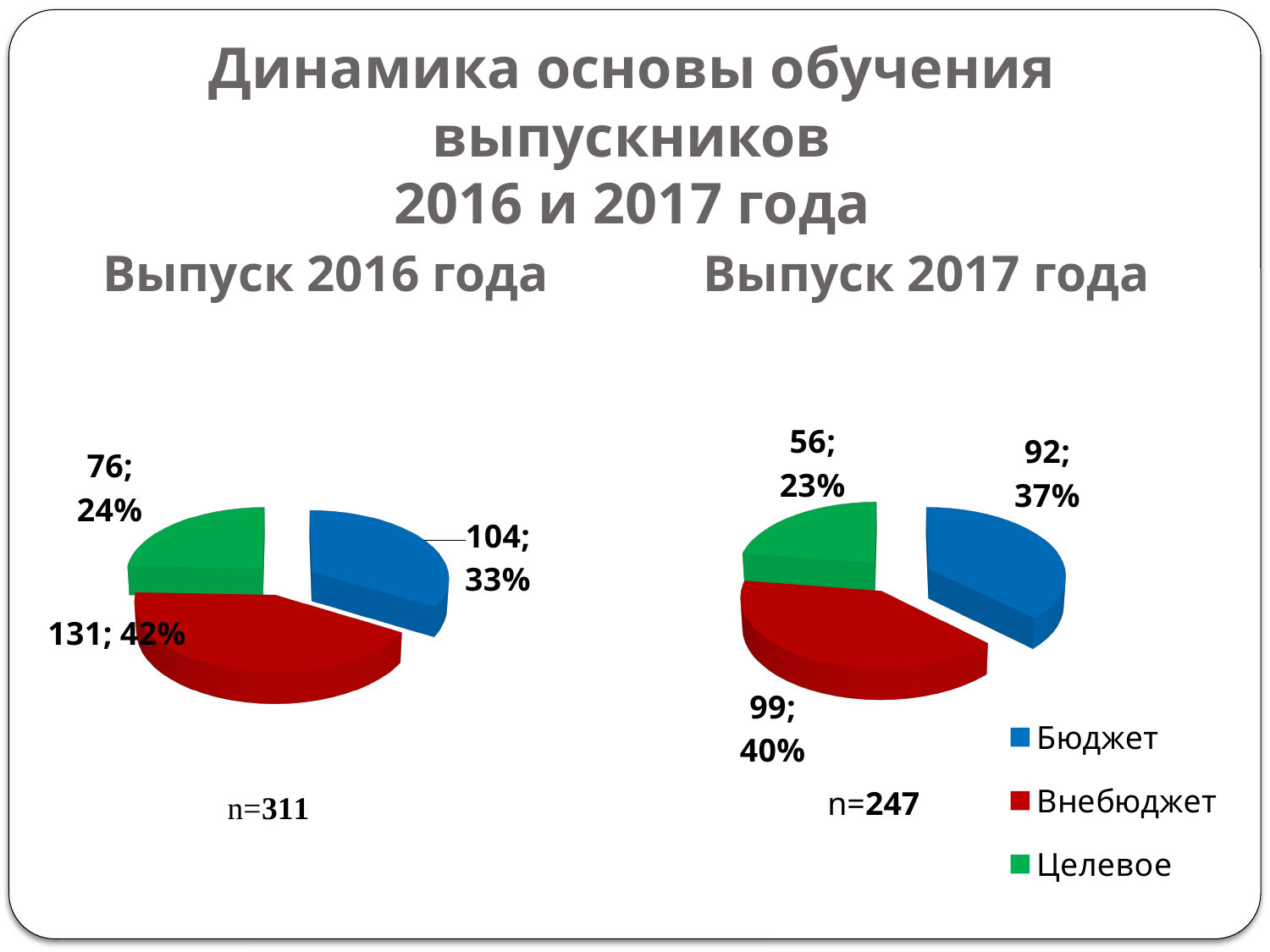
In the "Выпуск 2016 года" chart, what value is shown for Внебюджет? 131 In the "Выпуск 2016 года" chart, what percentage share does Целевое have? 24% In the "Выпуск 2016 года" chart, what is the difference between the Внебюджет and Бюджет values? 27 In the "Выпуск 2017 года" chart, what percentage share does Внебюджет have? 40% In the "Выпуск 2017 года" chart, what is the difference between the Бюджет and Целевое values? 36 Which colour represents Целевое in the legend? Green Which is larger: the Бюджет value in the "Выпуск 2016 года" chart or the Бюджет value in the "Выпуск 2017 года" chart? Выпуск 2016 года How many categories does each pie chart on the slide contain? 3 In the "Выпуск 2017 года" chart, which category has the smallest slice? Целевое In the "Выпуск 2016 года" chart, which category has the largest slice? Внебюджет What type of chart is used for "Выпуск 2017 года"? Pie chart In the "Выпуск 2017 года" chart, what value is shown for Бюджет? 92